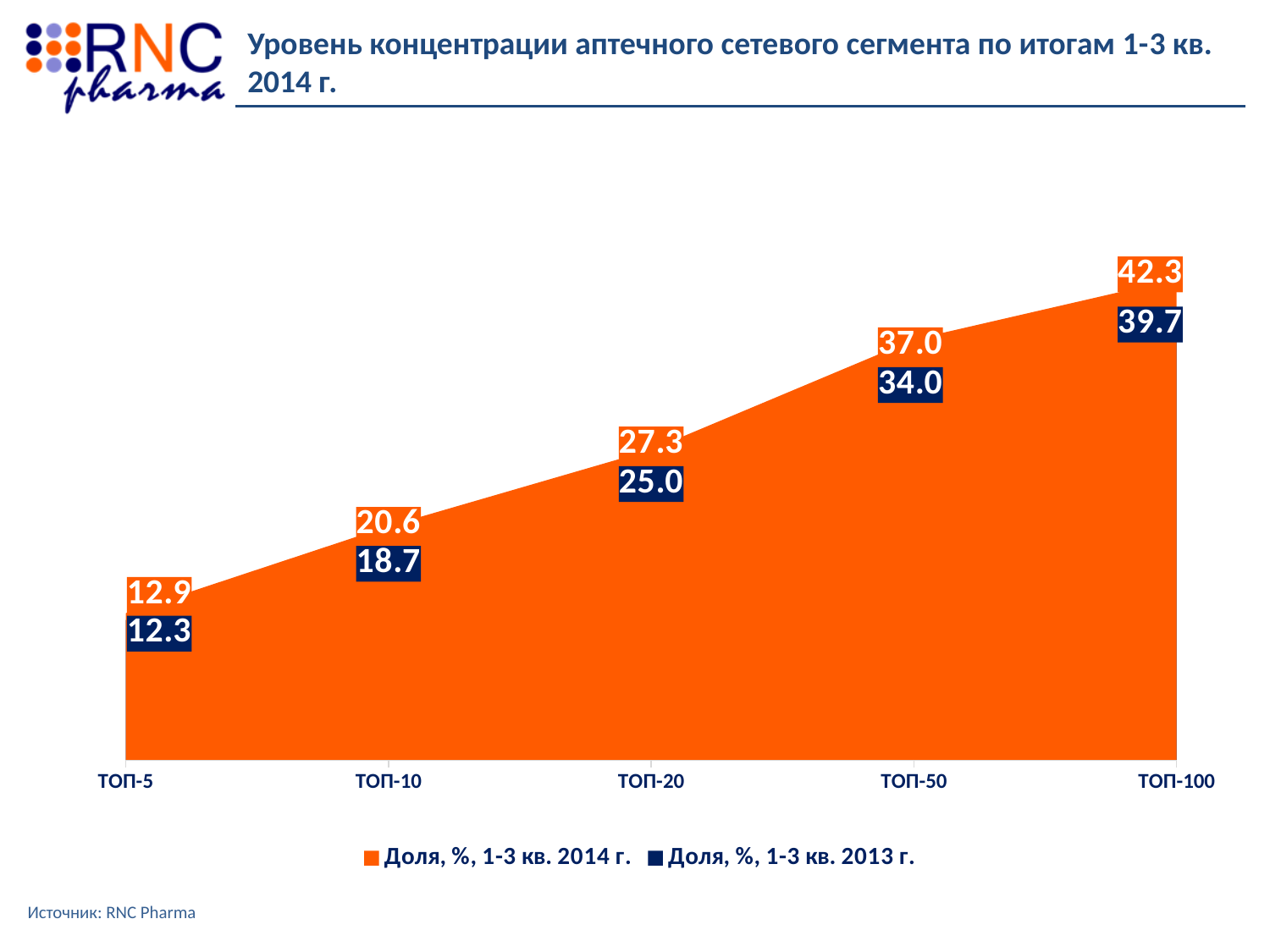
What kind of chart is shown on the slide? Area chart What is the value for ТОП-20 in the series 'Доля, %, 1-3 кв. 2014 г.'? 27.3 How many series does the legend list? 2 What is the difference between the 2014 values for ТОП-50 and ТОП-10? 16.4 What is the value for ТОП-5 in the series 'Доля, %, 1-3 кв. 2014 г.'? 12.9 Which is larger: the 2014 value for ТОП-10 or the 2013 value for ТОП-10? 2014 value (20.6) How many categories are shown on the x axis? 5 What is the difference between the 2014 and 2013 values for ТОП-100? 2.6 Which category has the highest value in the series 'Доля, %, 1-3 кв. 2014 г.'? ТОП-100 Which category has the lowest value in the series 'Доля, %, 1-3 кв. 2013 г.'? ТОП-5 What is the value for ТОП-50 in the series 'Доля, %, 1-3 кв. 2013 г.'? 34.0 Do the values rise or fall from ТОП-5 to ТОП-100? Rise